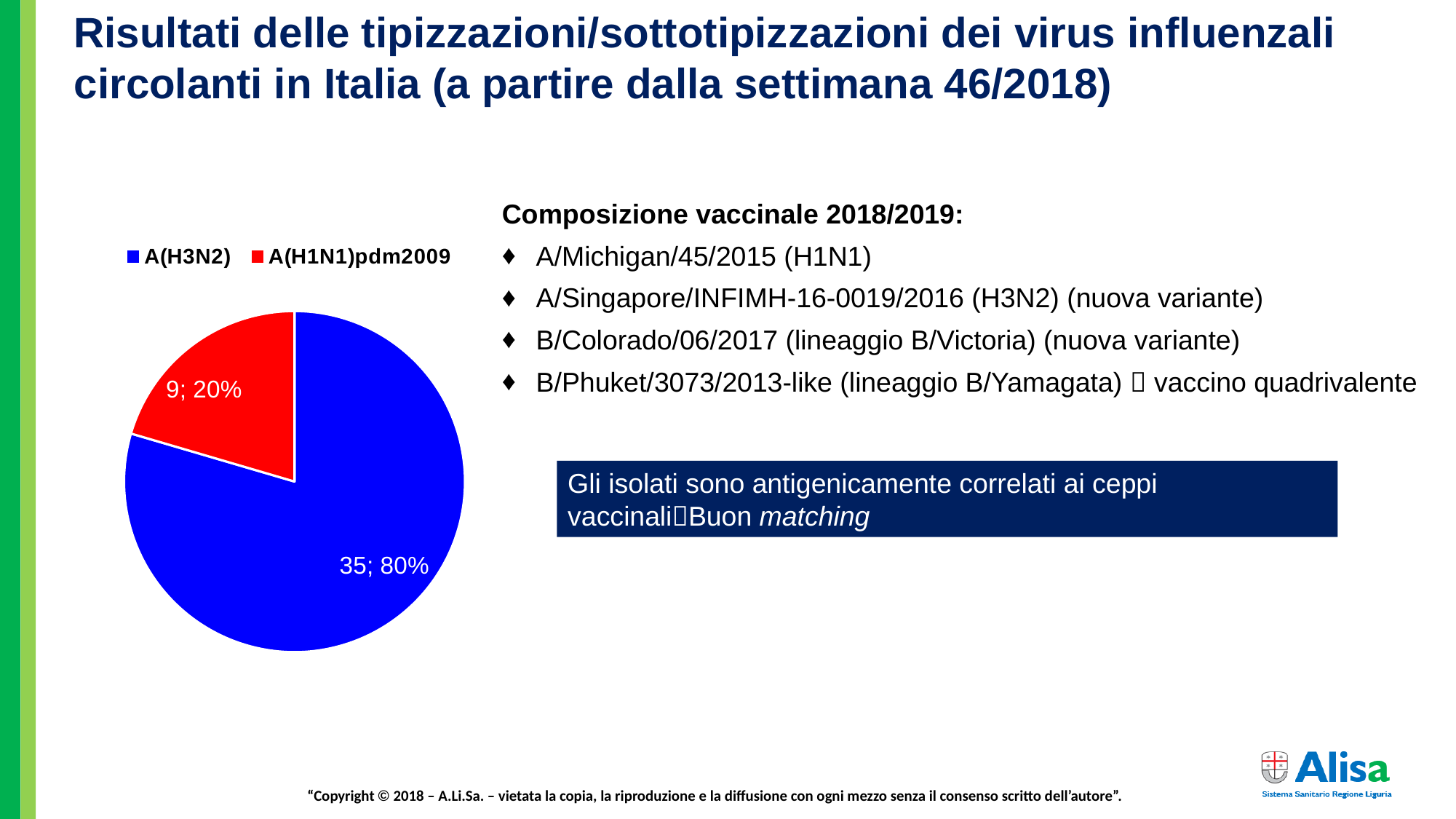
What share of the pie does A(H3N2) represent? 80% What is the difference between the counts for A(H3N2) and A(H1N1)pdm2009? 26 Which category has the largest slice in the pie chart? A(H3N2) What kind of chart is shown on the slide? pie chart How many slices does the pie chart have? 2 What share of the pie does A(H1N1)pdm2009 represent? 20% Which category has the smallest slice in the pie chart? A(H1N1)pdm2009 Which is larger, the count for A(H3N2) or the count for A(H1N1)pdm2009? A(H3N2) What colour is the A(H1N1)pdm2009 slice in the pie chart? red What is the count shown for A(H1N1)pdm2009 in the pie chart? 9 How many entries does the legend of the pie chart list? 2 What is the count shown for A(H3N2) in the pie chart? 35